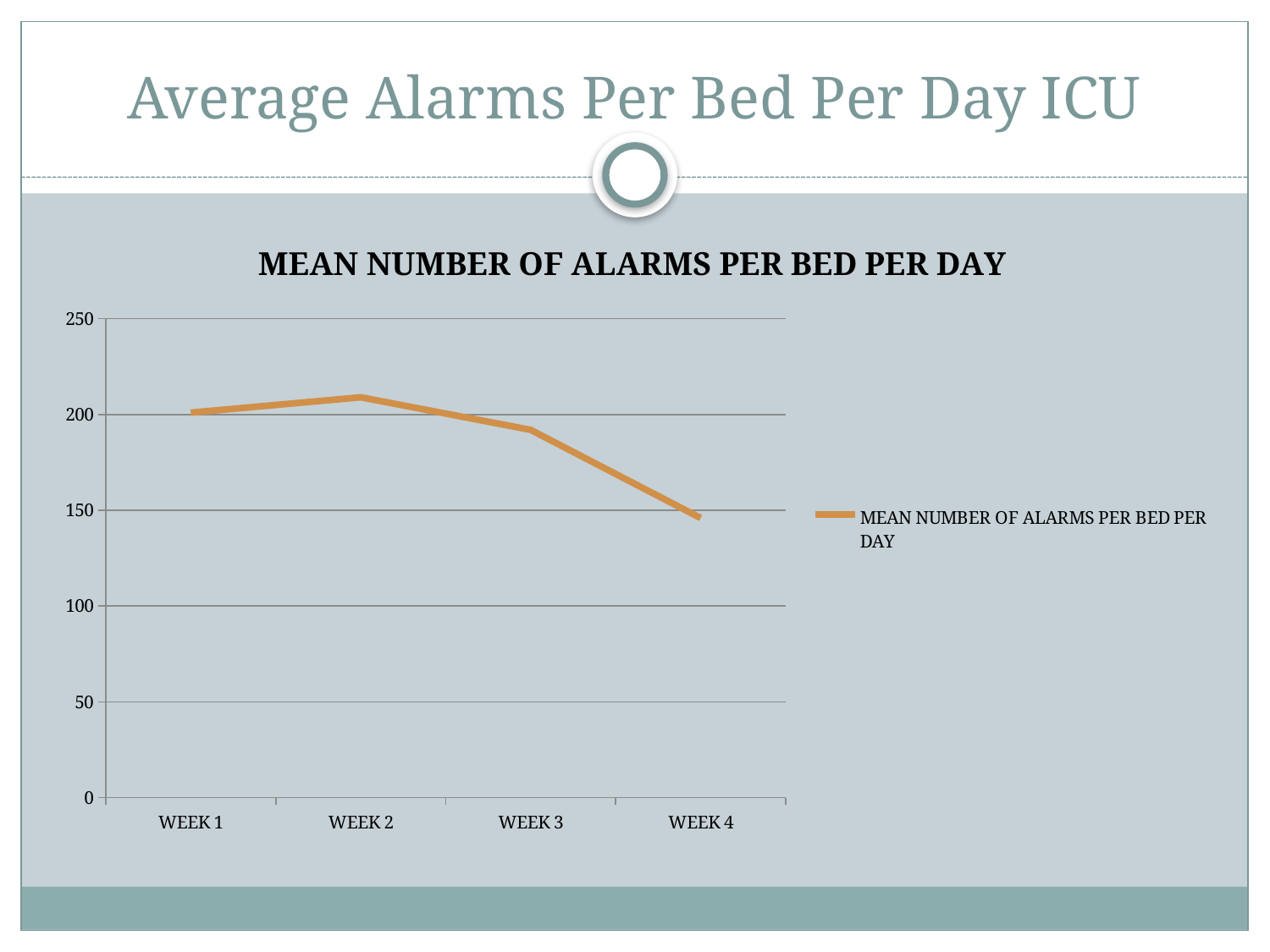
How many weeks are plotted on the x axis of the chart? 4 What is the legend entry shown to the right of the chart? MEAN NUMBER OF ALARMS PER BED PER DAY Which week has the lowest mean number of alarms per bed per day? WEEK 4 How many series does the chart's legend list? 1 What is the title of the chart? MEAN NUMBER OF ALARMS PER BED PER DAY What kind of chart is shown on the slide? Line chart Which week has the highest mean number of alarms per bed per day? WEEK 2 Does the mean number of alarms per bed per day rise or fall from WEEK 2 to WEEK 4? fall Is the value for WEEK 4 greater or less than 100? greater Is the value for WEEK 2 greater or less than 200? greater Which is larger, the value for WEEK 3 or the value for WEEK 4? WEEK 3 Is the value for WEEK 3 greater or less than 200? less